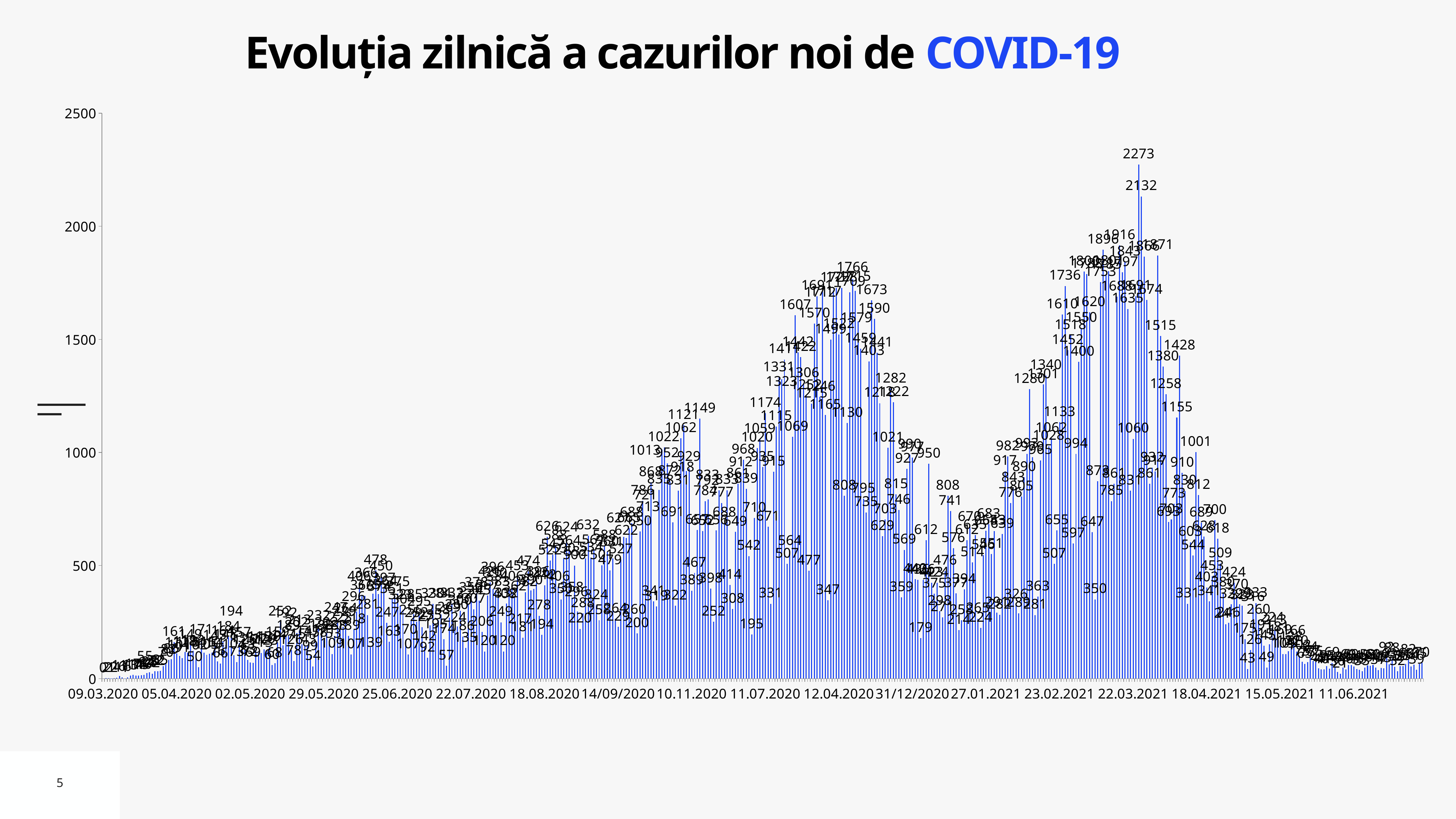
Is the highest bar on the chart greater or less than 2000? greater What is the last date label on the horizontal axis? 11.06.2021 What is the highest tick value shown on the vertical axis? 2500 What is the second-highest daily value labelled on the chart, just after the 2273 peak? 2132 Do the values rise or fall between the peak around 22.03.2021 and the end of the chart at 11.06.2021? fall What is the title of the chart? Evoluția zilnică a cazurilor noi de COVID-19 Which is larger, the peak value of 2273 or the neighbouring value of 2132? 2273 What is the highest daily value labelled on the chart? 2273 Are the values at the far right of the chart, around 11.06.2021, greater or less than 500? less What is the difference between the two highest labelled values, 2273 and 2132? 141 What kind of chart is shown on the slide? bar chart What is the first date label on the horizontal axis? 09.03.2020